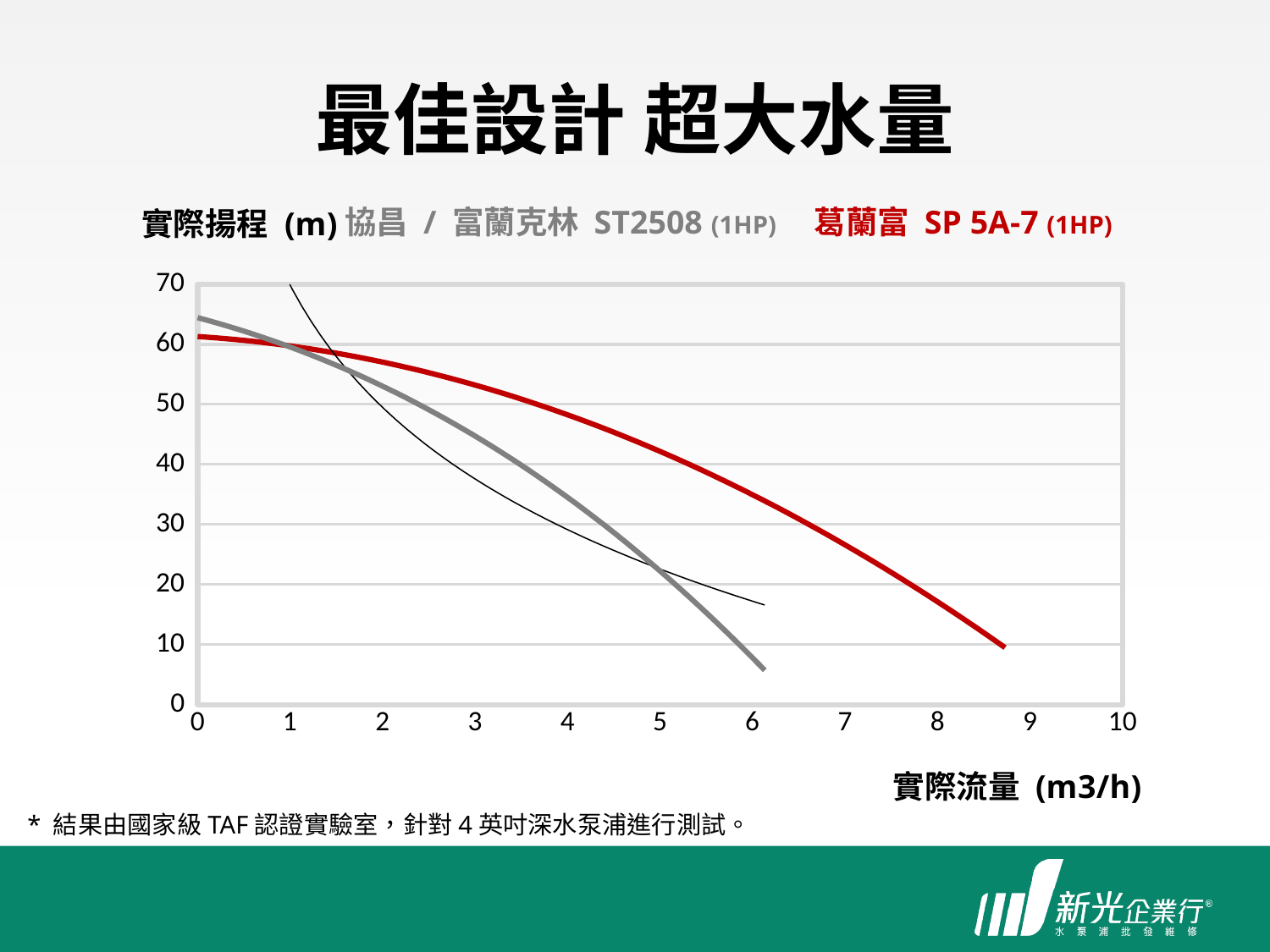
What is the title of the slide above the chart? 最佳設計 超大水量 Is the head of the gray 協昌 / 富蘭克林 ST2508 curve at a flow of 5 m3/h greater or less than 30? less How many named pump models are listed in the legend above the chart? 2 Which curve extends to the highest flow rate on the x axis? 葛蘭富 SP 5A-7 What is the label of the x axis of the chart? 實際流量 (m3/h) At a flow of 5 m3/h, which curve shows the higher head: 葛蘭富 SP 5A-7 (red) or 協昌 / 富蘭克林 ST2508 (gray)? 葛蘭富 SP 5A-7 What is the highest value shown on the y axis of the chart? 70 Is the head of the red 葛蘭富 SP 5A-7 curve at a flow of 5 m3/h greater or less than 50? less At a flow of 0 m3/h, which curve starts higher: the gray 協昌 / 富蘭克林 ST2508 curve or the red 葛蘭富 SP 5A-7 curve? 協昌 / 富蘭克林 ST2508 As the flow rate (實際流量) increases along the x axis, do the curves rise or fall? fall What kind of chart is shown on the slide? line chart